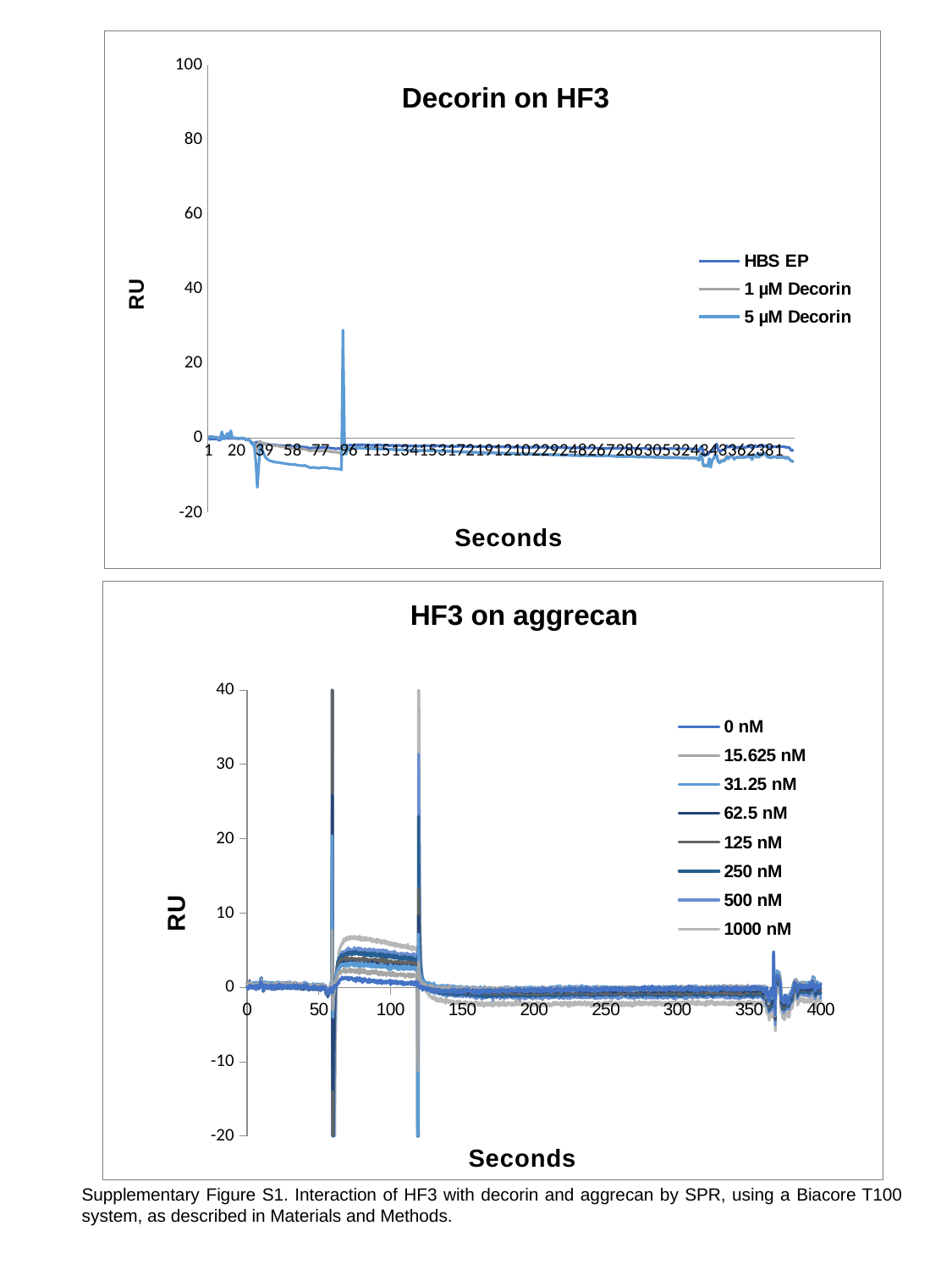
In the "HF3 on aggrecan" chart, is the value of the 1000 nM series at around 100 seconds greater or less than 0? greater What kind of chart is the "Decorin on HF3" chart? line chart How many series does the legend of the "HF3 on aggrecan" chart list? 8 In the "Decorin on HF3" chart, is the peak value of the 5 µM Decorin series near 96 seconds greater or less than 40? less In the "HF3 on aggrecan" chart, is the value of the 1000 nM series at around 100 seconds greater or less than 10? less How many series does the legend of the "Decorin on HF3" chart list? 3 In the "HF3 on aggrecan" chart, what is the label of the x axis? Seconds In the "HF3 on aggrecan" chart, which series has the highest plateau between about 60 and 120 seconds? 1000 nM What kind of chart is the "HF3 on aggrecan" chart? line chart In the "Decorin on HF3" chart, what is the label of the y axis? RU